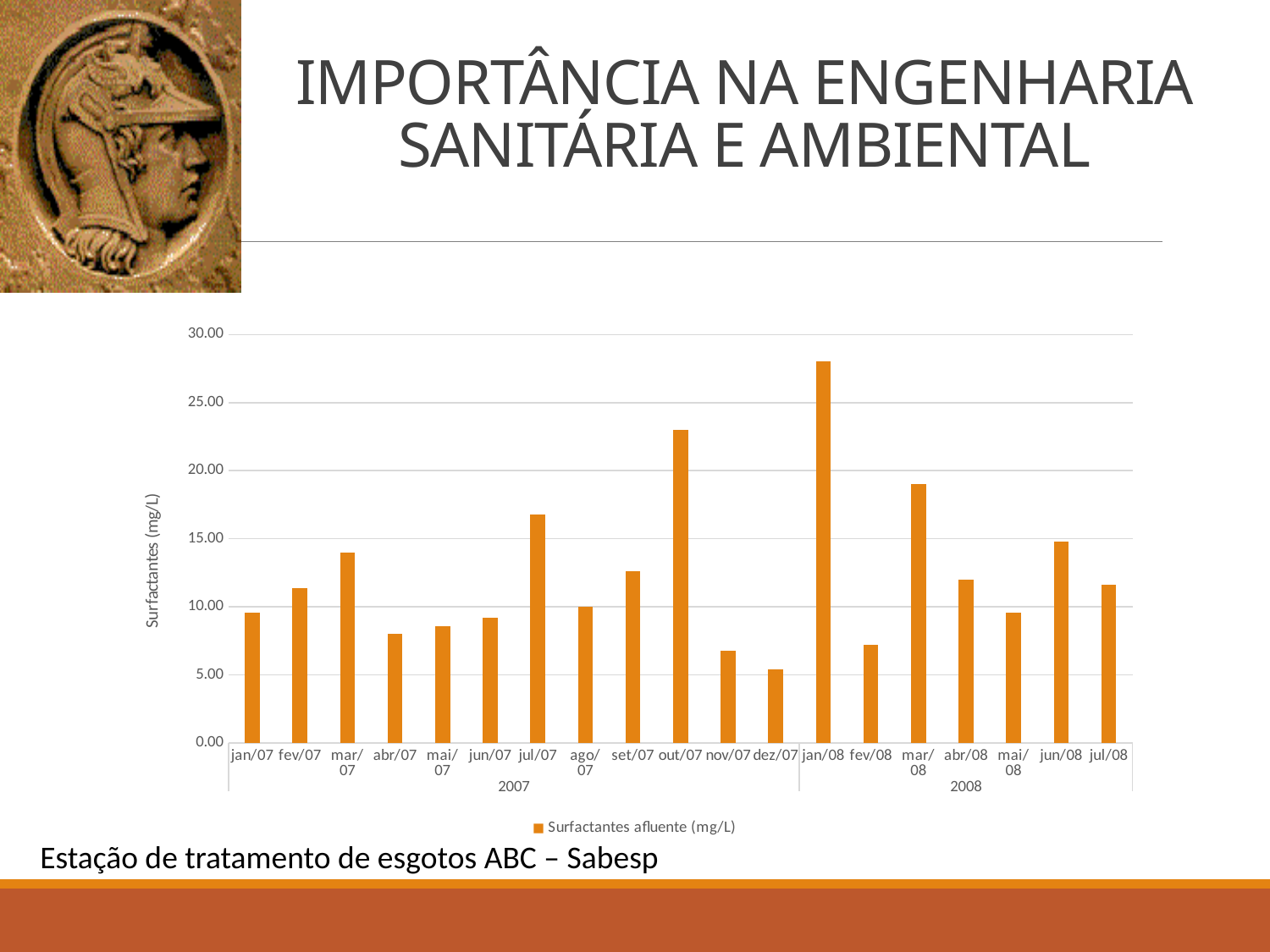
Which is larger, the value for jul/07 or the value for set/07? jul/07 How many series does the legend list? 1 Which is larger, the value for out/07 or the value for mar/08? out/07 Is the value for out/07 greater or less than 20.00? greater Is the value for jan/08 greater or less than 25.00? greater How many months (bars) are plotted in the chart? 19 Is the value for mar/08 greater or less than 20.00? less Which month has the lowest surfactant value? dez/07 What is the label of the vertical axis? Surfactantes (mg/L) Which month has the highest surfactant value? jan/08 What kind of chart is shown on the slide? bar chart